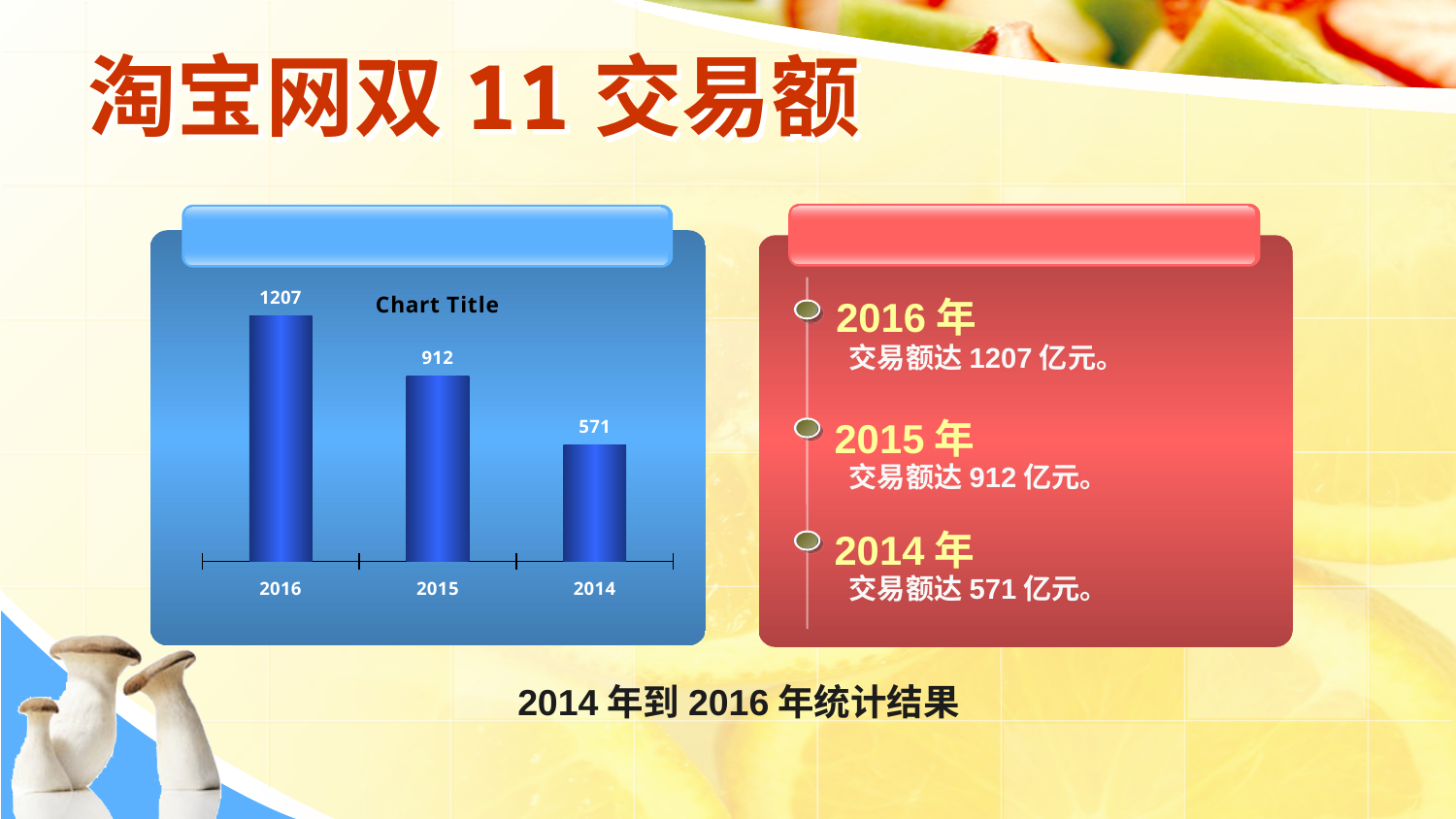
What is the difference between the values for 2016 and 2015? 295 How many categories are shown on the x axis of the chart? 3 What is the value for 2016 in the chart? 1207 Which category has the highest value in the chart? 2016 What is the value for 2014 in the chart? 571 Do the values rise or fall from left to right along the x axis? fall Which category has the lowest value in the chart? 2014 Which is larger, the value for 2015 or the value for 2014? 2015 What kind of chart is shown on the slide? bar chart What is the difference between the values for 2015 and 2014? 341 What is the value for 2015 in the chart? 912 What is the difference between the values for 2016 and 2014? 636